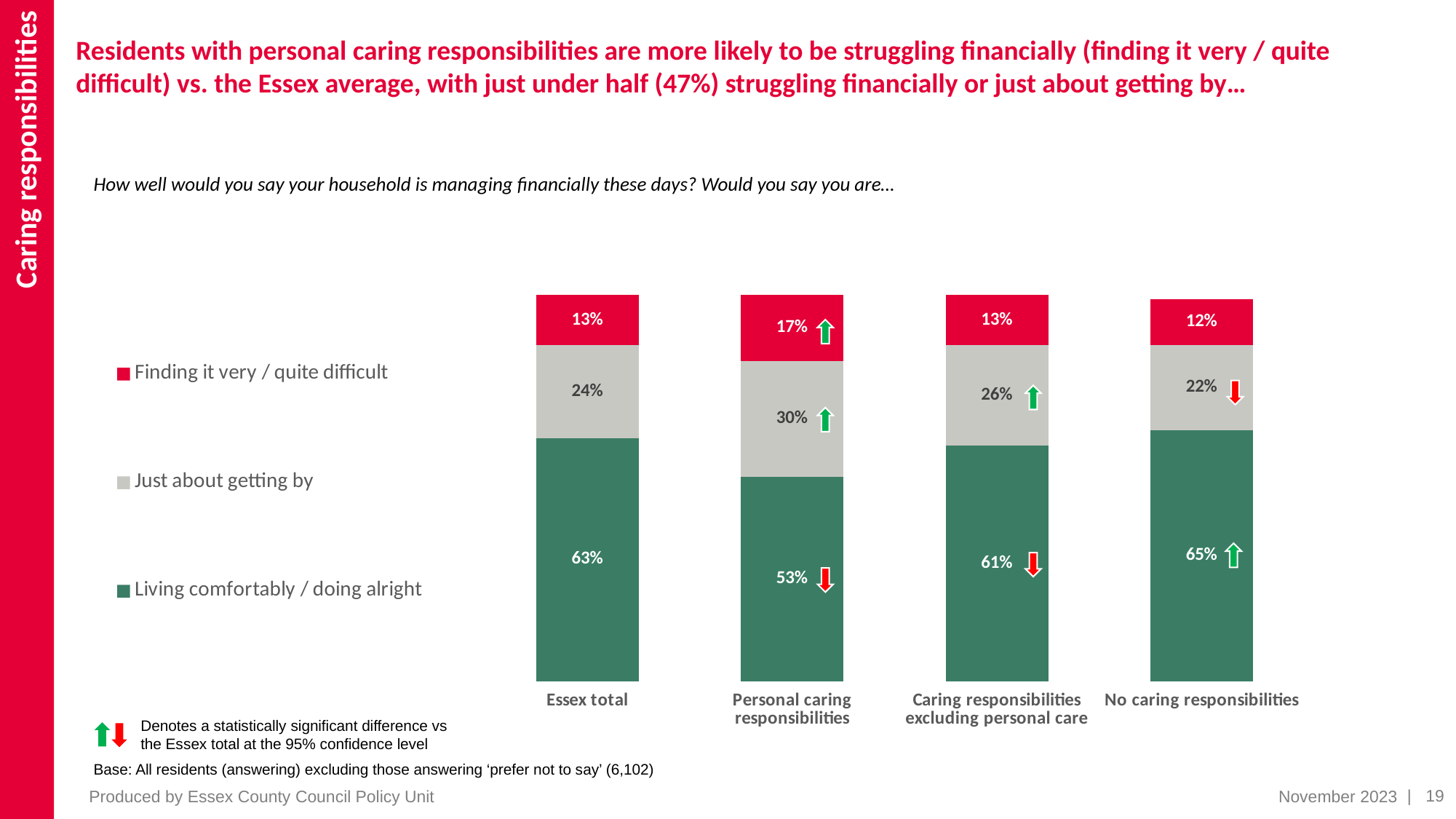
How many series does the legend list? 3 What percentage of residents with caring responsibilities excluding personal care are finding it very / quite difficult? 13% What kind of chart is shown on the slide? Stacked bar chart What percentage of residents with no caring responsibilities are just about getting by? 22% How many categories are shown on the x axis of the chart? 4 Which is larger: the 'Finding it very / quite difficult' share for personal caring responsibilities or for no caring responsibilities? Personal caring responsibilities Which category has the lowest percentage living comfortably / doing alright? Personal caring responsibilities What percentage of the Essex total are living comfortably / doing alright? 63% What is the difference in the 'Just about getting by' percentage between personal caring responsibilities and the Essex total? 6% What colour represents 'Finding it very / quite difficult' in the chart? Red Which category has the highest percentage living comfortably / doing alright? No caring responsibilities What percentage of residents with personal caring responsibilities are finding it very / quite difficult? 17%